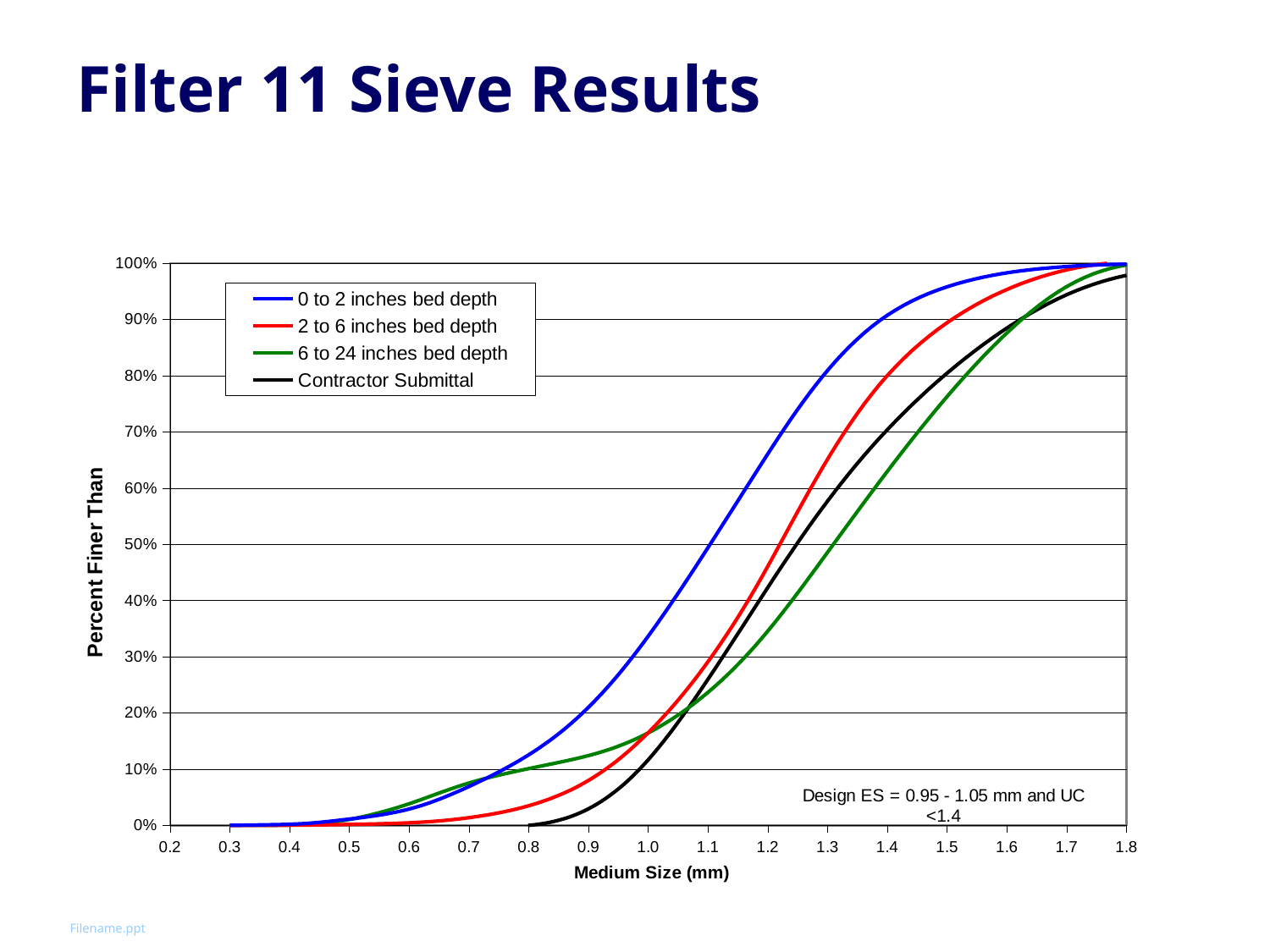
What is the title of the x axis? Medium Size (mm) At a medium size of 1.5 mm, is the value for the 0 to 2 inches bed depth series greater or less than 90%? greater What is the title of the y axis? Percent Finer Than At a medium size of 1.2 mm, is the value for the 6 to 24 inches bed depth series greater or less than 50%? less At a medium size of 1.2 mm, which series has the lowest value? 6 to 24 inches bed depth Do the curves rise or fall as Medium Size increases along the x axis? Rise How many series does the legend list? 4 At a medium size of 0.9 mm, is the value for the Contractor Submittal series greater or less than 10%? less At a medium size of 1.0 mm, which series has the higher value: 0 to 2 inches bed depth or 2 to 6 inches bed depth? 0 to 2 inches bed depth What kind of chart is shown on the slide? Line chart